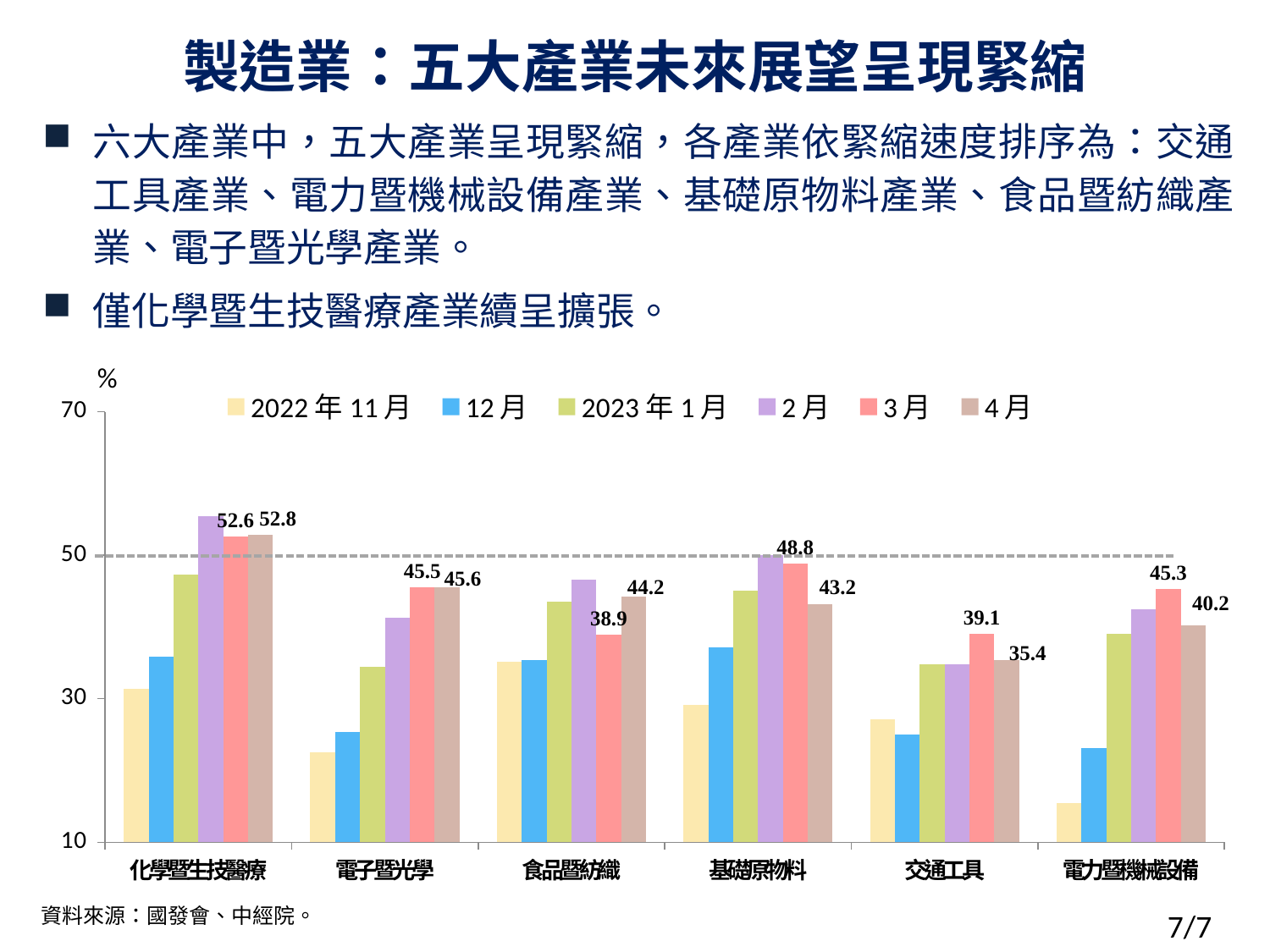
What is the value for 食品暨紡織 in the 3月 series? 38.9 Which is larger for 基礎原物料: the 3月 value or the 4月 value? 3月 What is the value for 基礎原物料 in the 3月 series? 48.8 What is the value for 交通工具 in the 4月 series? 35.4 Which category has the lowest value in the 4月 series? 交通工具 What is the difference between the 3月 and 4月 values for 電力暨機械設備? 5.1 Which category has the highest value in the 4月 series? 化學暨生技醫療 What kind of chart is shown on the slide? bar chart How many industry categories are shown on the x axis? 6 What is the value for 化學暨生技醫療 in the 4月 series? 52.8 Is the 2022年11月 value for 電力暨機械設備 greater or less than 30? less How many series does the legend list? 6